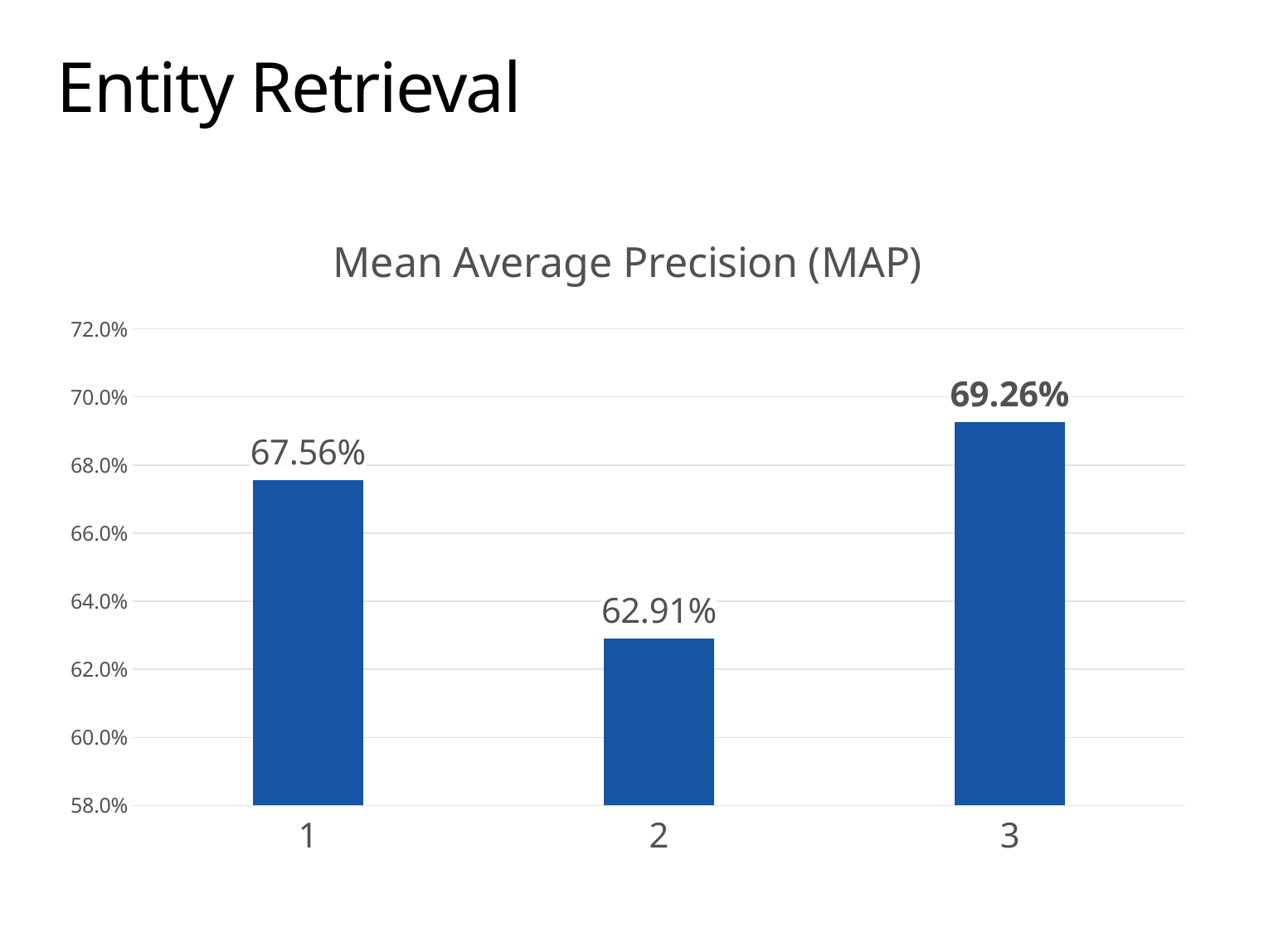
What kind of chart is shown on the slide? bar chart What is the Mean Average Precision (MAP) value for category 2? 62.91% What is the title of the chart? Mean Average Precision (MAP) What is the difference between the MAP values for category 1 and category 2? 4.65% What is the Mean Average Precision (MAP) value for category 3? 69.26% How many categories are shown in the chart? 3 Is the MAP value for category 2 greater or less than 64.0%? less What is the difference between the MAP values for category 3 and category 1? 1.70% Which category has the highest Mean Average Precision (MAP)? 3 Which has a larger MAP value, category 1 or category 2? 1 Which category has the lowest Mean Average Precision (MAP)? 2 What is the Mean Average Precision (MAP) value for category 1? 67.56%